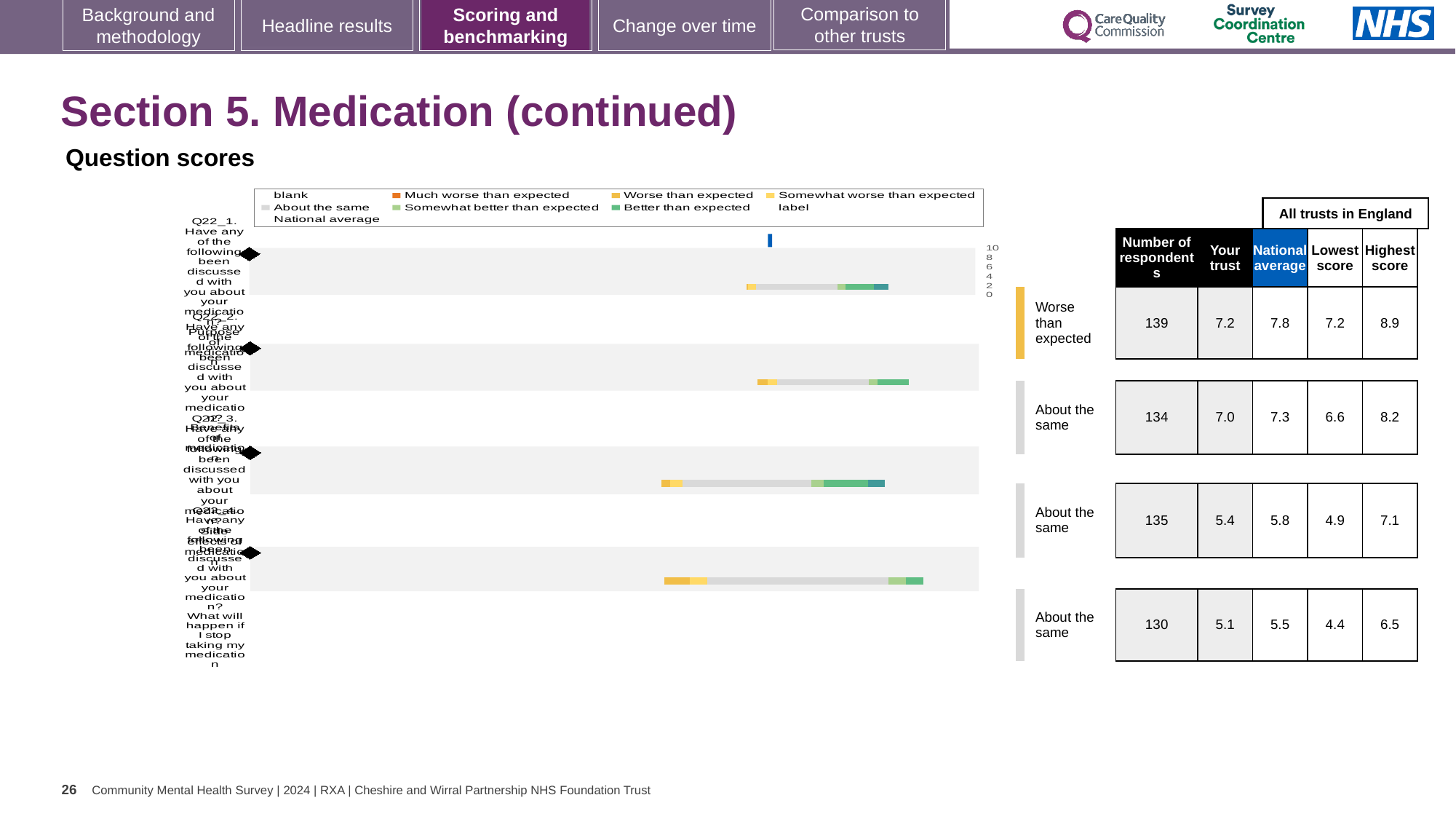
In the table, what is the number of respondents for the first question row? 139 In the table, what is the highest score for the fourth question row? 6.5 Which is larger: the 'Your trust' score for the third row or for the fourth row? the third row (5.4) In the table, what is the national average for the second question row? 7.3 For the first question row, what is the difference between the national average and the 'Your trust' score? 0.6 Which question row has the lowest number of respondents in the table? the fourth row (130) What benchmark label is shown next to the first question row? Worse than expected In the table, what is the 'Your trust' score for the first question row? 7.2 How many question rows are plotted in the chart? 4 What kind of chart is shown on the slide? bar chart What heading appears above the table columns to the right of the chart? All trusts in England Which question row has the highest 'Your trust' score in the table? the first row (7.2)